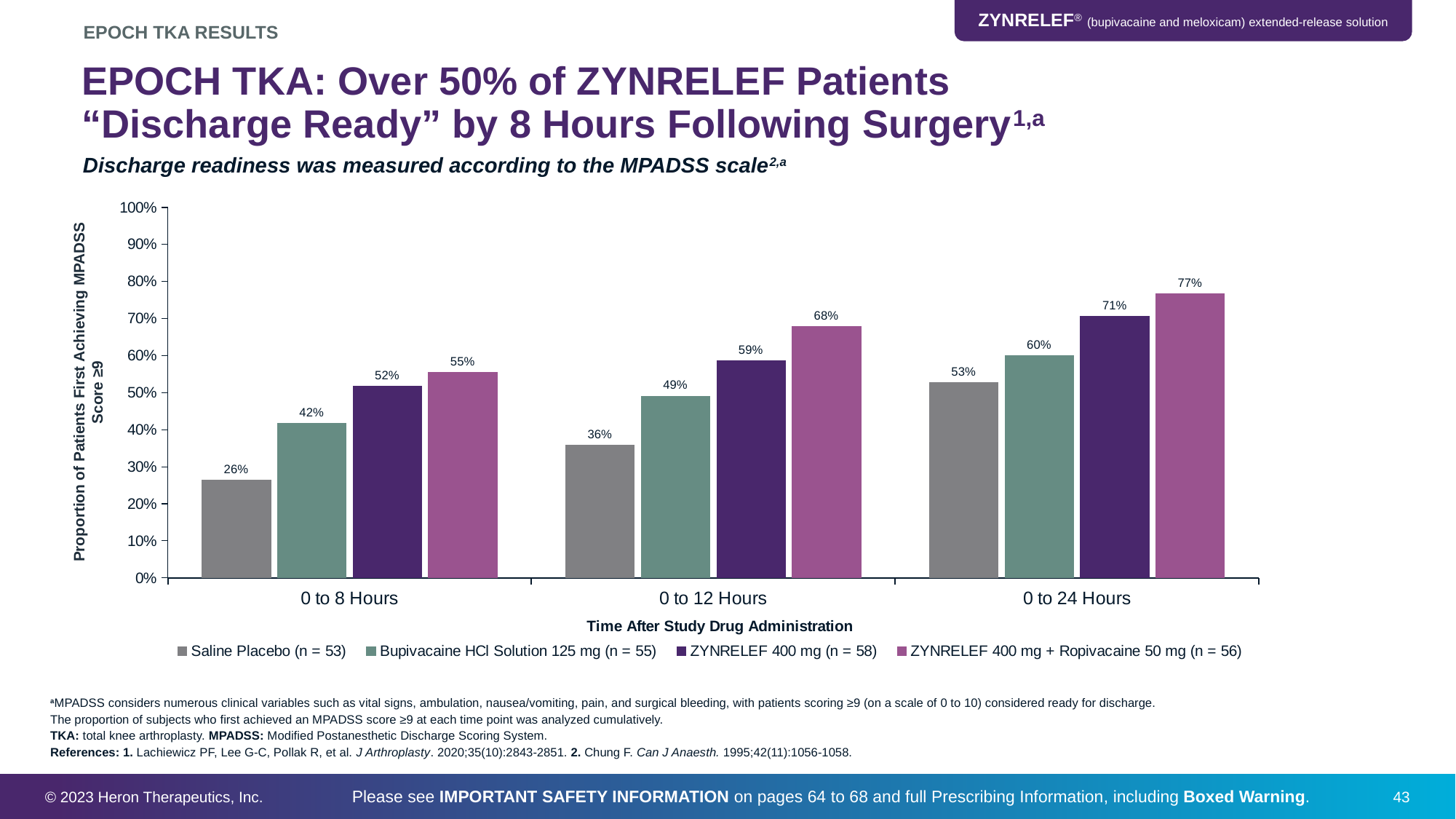
What is the value for ZYNRELEF 400 mg + Ropivacaine 50 mg at 0 to 24 Hours? 77% Which is larger: ZYNRELEF 400 mg at 0 to 8 Hours or Bupivacaine HCl Solution 125 mg at 0 to 24 Hours? Bupivacaine HCl Solution 125 mg at 0 to 24 Hours Is the value for ZYNRELEF 400 mg at 0 to 24 Hours greater or less than 60%? greater What is the difference between ZYNRELEF 400 mg and Saline Placebo at 0 to 12 Hours? 23% What is the value for Bupivacaine HCl Solution 125 mg at 0 to 12 Hours? 49% How many series does the legend list? 4 Which series has the lowest value at 0 to 8 Hours? Saline Placebo (n = 53) What kind of chart is shown on the slide? Bar chart How many time-point categories are shown on the x axis? 3 Do the values for Saline Placebo rise or fall from 0 to 8 Hours to 0 to 24 Hours? Rise Which series has the highest value at 0 to 24 Hours? ZYNRELEF 400 mg + Ropivacaine 50 mg (n = 56) What is the value for Saline Placebo at 0 to 8 Hours? 26%